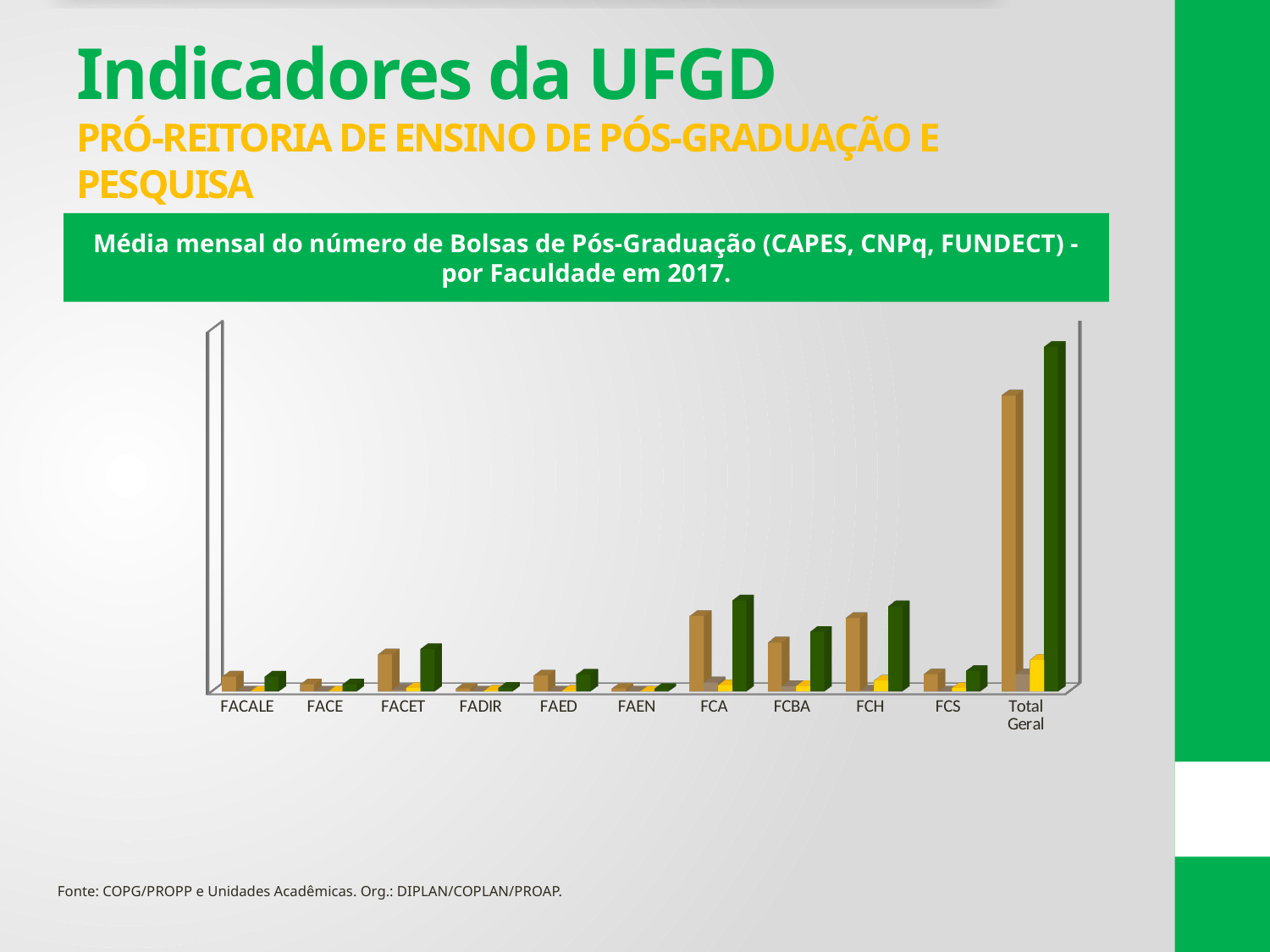
Which category has the tallest bars in the chart? Total Geral How many categories are shown along the x axis of the chart? 11 What kind of chart is shown on the slide? bar chart Is the dark green bar for FCH larger or smaller than the dark green bar for FCS? larger Excluding Total Geral, which faculty has the tallest dark green bar? FCA Which is larger for Total Geral, the tan bar or the dark green bar? the dark green bar How many bars are plotted for each category in the chart? 4 What is the title of the chart? Média mensal do número de Bolsas de Pós-Graduação (CAPES, CNPq, FUNDECT) - por Faculdade em 2017. Is the tan bar for FCA larger or smaller than the tan bar for FACE? larger